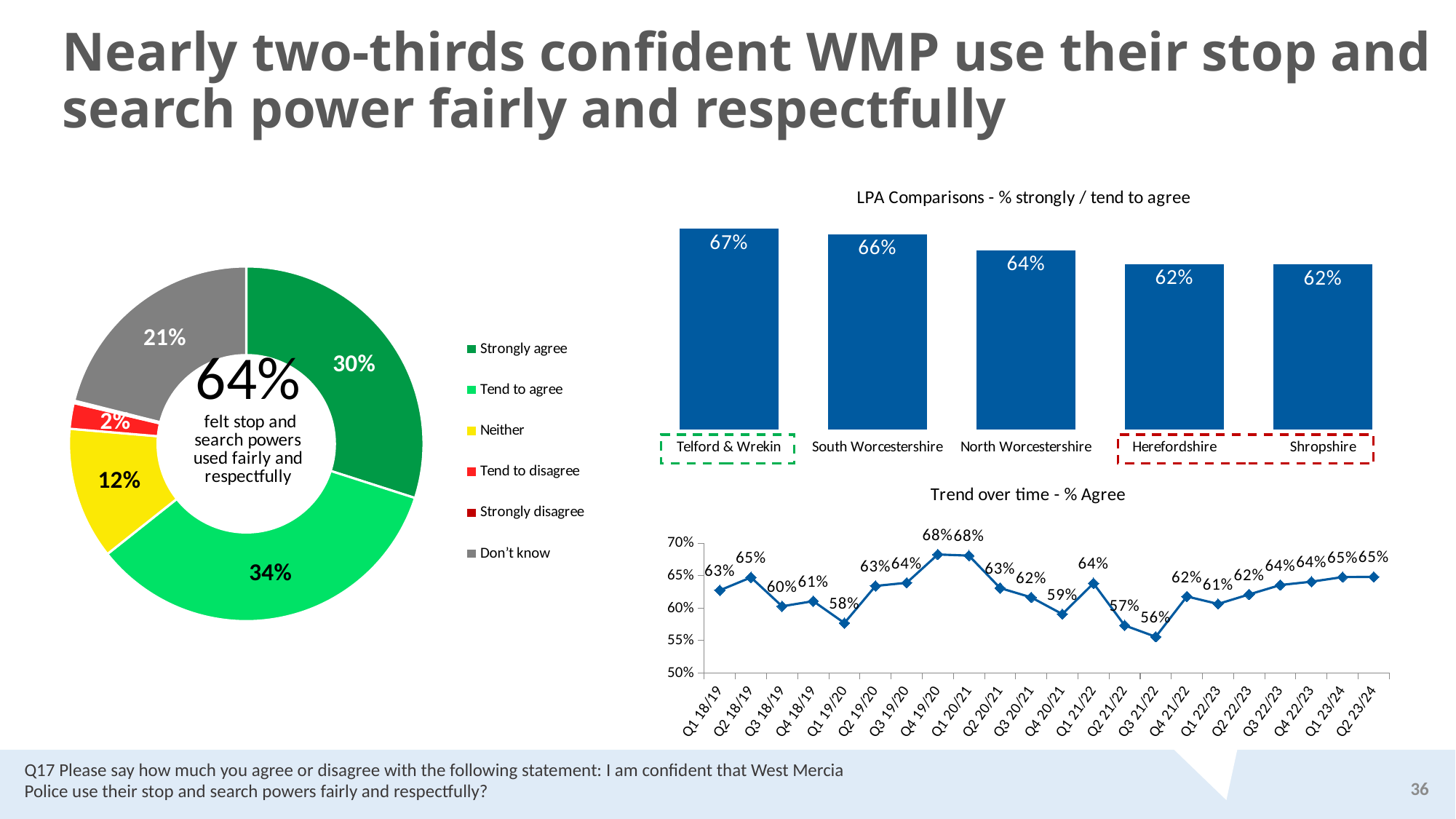
In the donut chart on the left, what percentage answered 'Don't know'? 21% In the Trend over time chart, which quarter(s) have the highest value? Q4 19/20 and Q1 20/21 How many entries does the legend of the donut chart on the left list? 6 In the LPA Comparisons chart, how many LPAs are shown? 5 What type of chart is the Trend over time - % Agree chart? Line chart In the LPA Comparisons chart, what is the difference between South Worcestershire and Herefordshire? 4 percentage points In the donut chart on the left, which is larger: 'Strongly agree' or 'Neither'? Strongly agree In the Trend over time chart, what is the difference between Q1 21/22 and Q2 21/22? 7 percentage points In the donut chart on the left, what share of respondents said 'Tend to agree'? 34% In the LPA Comparisons chart, what is the value for Telford & Wrekin? 67% In the LPA Comparisons chart, which LPA has the highest value? Telford & Wrekin In the Trend over time chart, what is the value for Q3 21/22? 56%